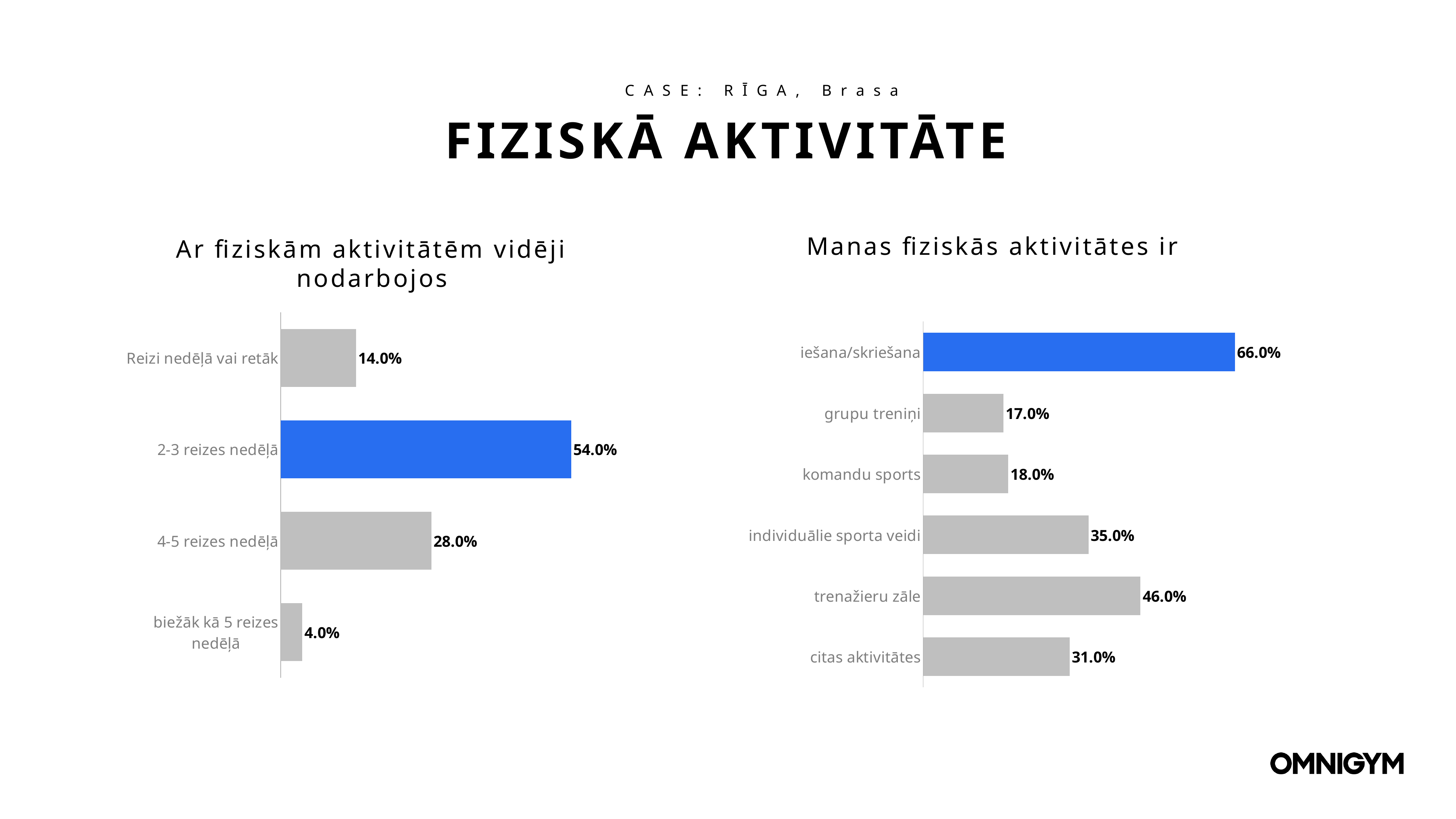
In the right chart 'Manas fiziskās aktivitātes ir', what is the value for 'komandu sports'? 18.0% In the left chart 'Ar fiziskām aktivitātēm vidēji nodarbojos', how many categories are shown? 4 In the left chart 'Ar fiziskām aktivitātēm vidēji nodarbojos', what is the difference between '4-5 reizes nedēļā' and 'Reizi nedēļā vai retāk'? 14.0% In the right chart 'Manas fiziskās aktivitātes ir', which category has the highest value? iešana/skriešana In the left chart 'Ar fiziskām aktivitātēm vidēji nodarbojos', what is the value for '2-3 reizes nedēļā'? 54.0% What type of chart is the right chart 'Manas fiziskās aktivitātes ir'? Bar chart In the right chart 'Manas fiziskās aktivitātes ir', how many categories are shown? 6 In the left chart 'Ar fiziskām aktivitātēm vidēji nodarbojos', which category has the lowest value? biežāk kā 5 reizes nedēļā In the right chart 'Manas fiziskās aktivitātes ir', what is the value for 'trenažieru zāle'? 46.0% In the left chart 'Ar fiziskām aktivitātēm vidēji nodarbojos', which bar is coloured blue? 2-3 reizes nedēļā In the right chart 'Manas fiziskās aktivitātes ir', what is the difference between 'iešana/skriešana' and 'grupu treniņi'? 49.0% In the right chart 'Manas fiziskās aktivitātes ir', which is larger: 'individuālie sporta veidi' or 'citas aktivitātes'? individuālie sporta veidi